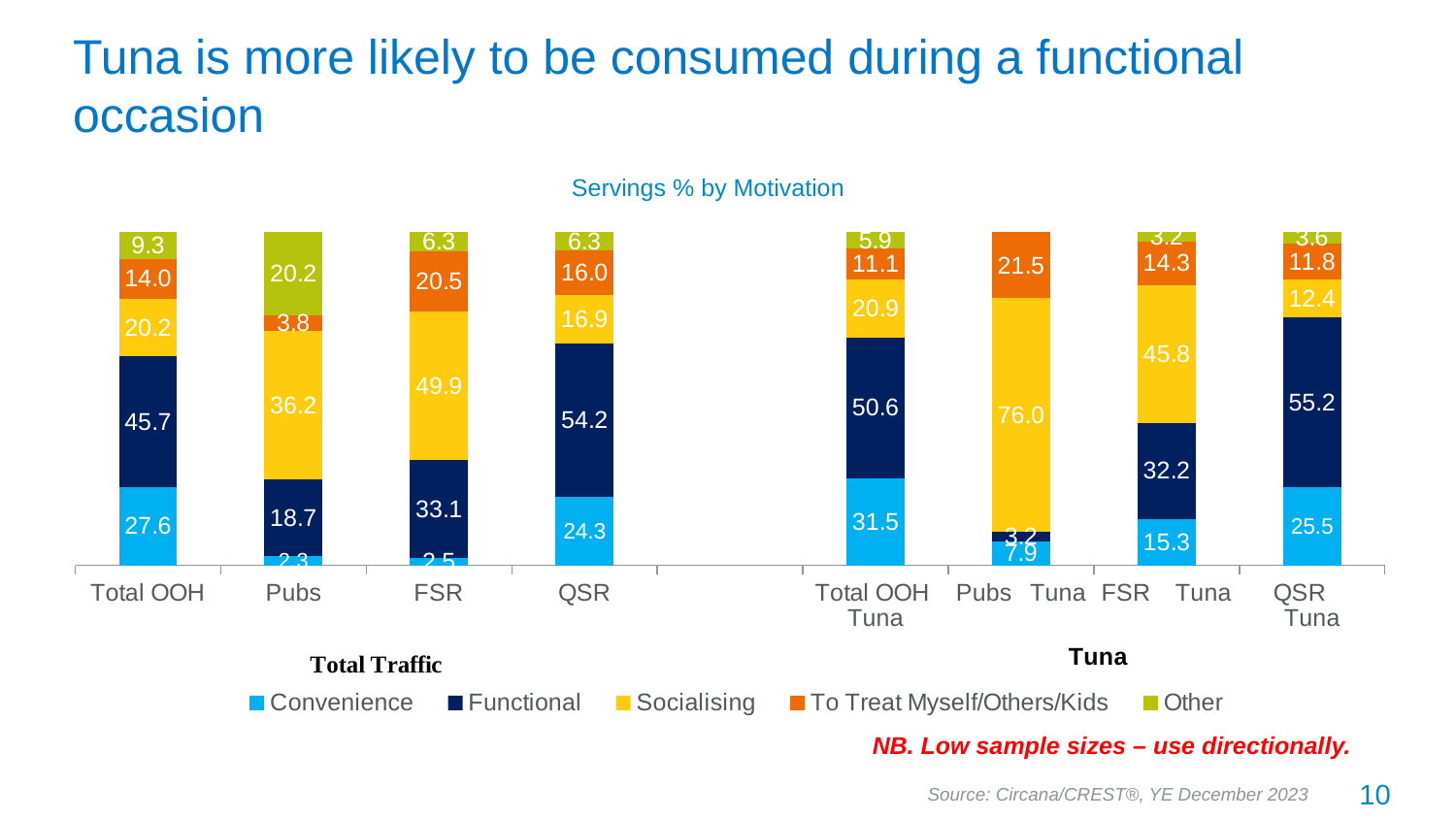
What is the Functional value for Total OOH? 45.7 What is the difference between the Functional values for QSR and Total OOH? 8.5 What is the Convenience value for QSR Tuna? 25.5 What is the To Treat Myself/Others/Kids value for FSR? 20.5 Which category has the highest Socialising value? Pubs Tuna Which is larger, the Convenience value for Total OOH Tuna or for Total OOH? Total OOH Tuna How many series does the legend list? 5 What type of chart is shown on the slide? Stacked bar chart Which category has the highest Functional value? QSR Tuna How many categories are shown along the x axis? 8 What is the Socialising value for Pubs Tuna? 76.0 What is the title of the chart? Servings % by Motivation